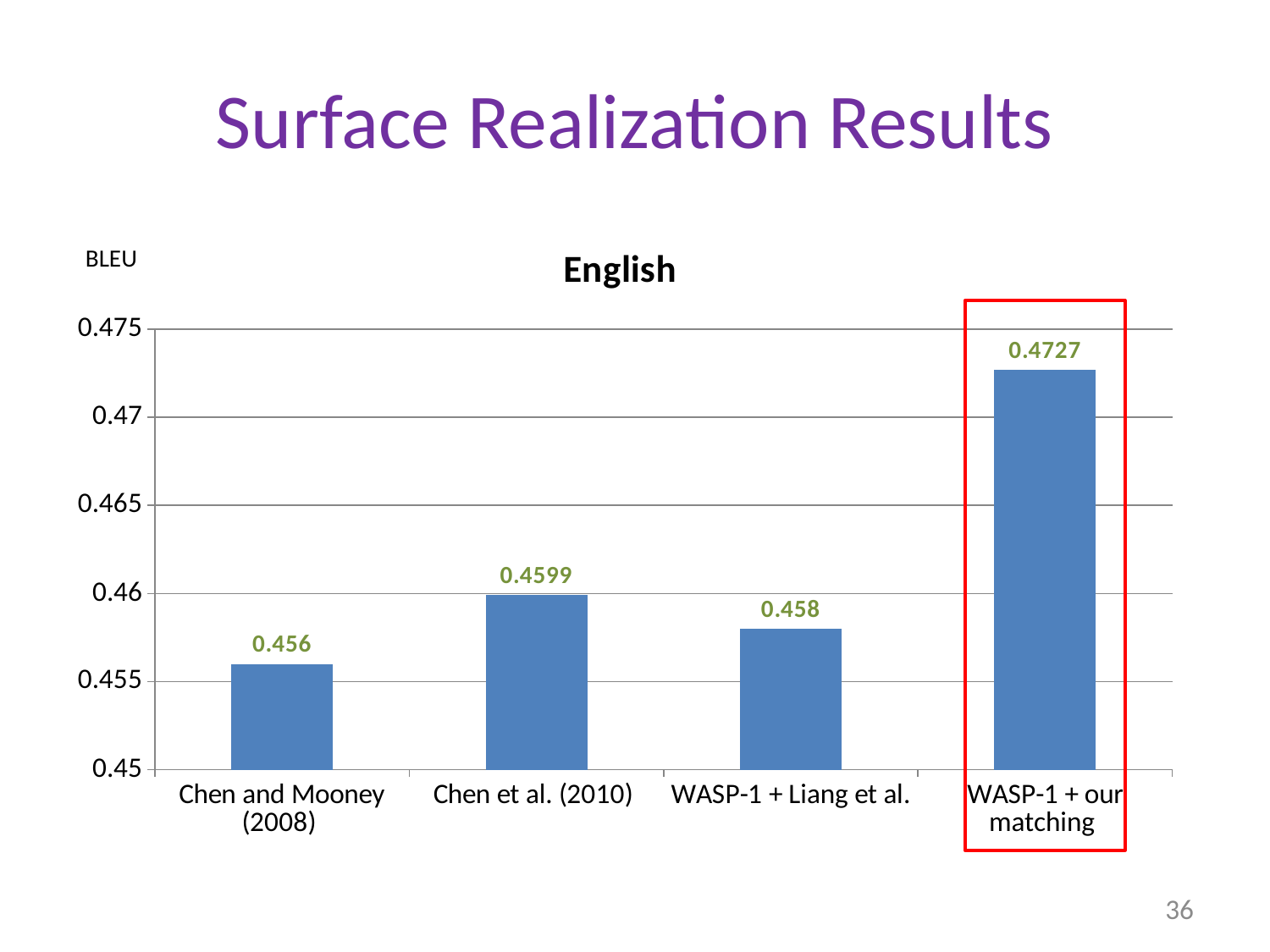
Which system has the highest BLEU score? WASP-1 + our matching What is the title of the chart? English Which system has the lowest BLEU score? Chen and Mooney (2008) What kind of chart is shown on the slide? bar chart What is the difference in BLEU between WASP-1 + our matching and Chen et al. (2010)? 0.0128 What is the BLEU value for Chen et al. (2010)? 0.4599 Which has a higher BLEU score, Chen et al. (2010) or WASP-1 + Liang et al.? Chen et al. (2010) What is the BLEU value for WASP-1 + Liang et al.? 0.458 What is the BLEU value for Chen and Mooney (2008)? 0.456 How many systems are compared in the chart? 4 Is the BLEU value for WASP-1 + our matching greater or less than 0.47? greater What is the BLEU value for WASP-1 + our matching? 0.4727